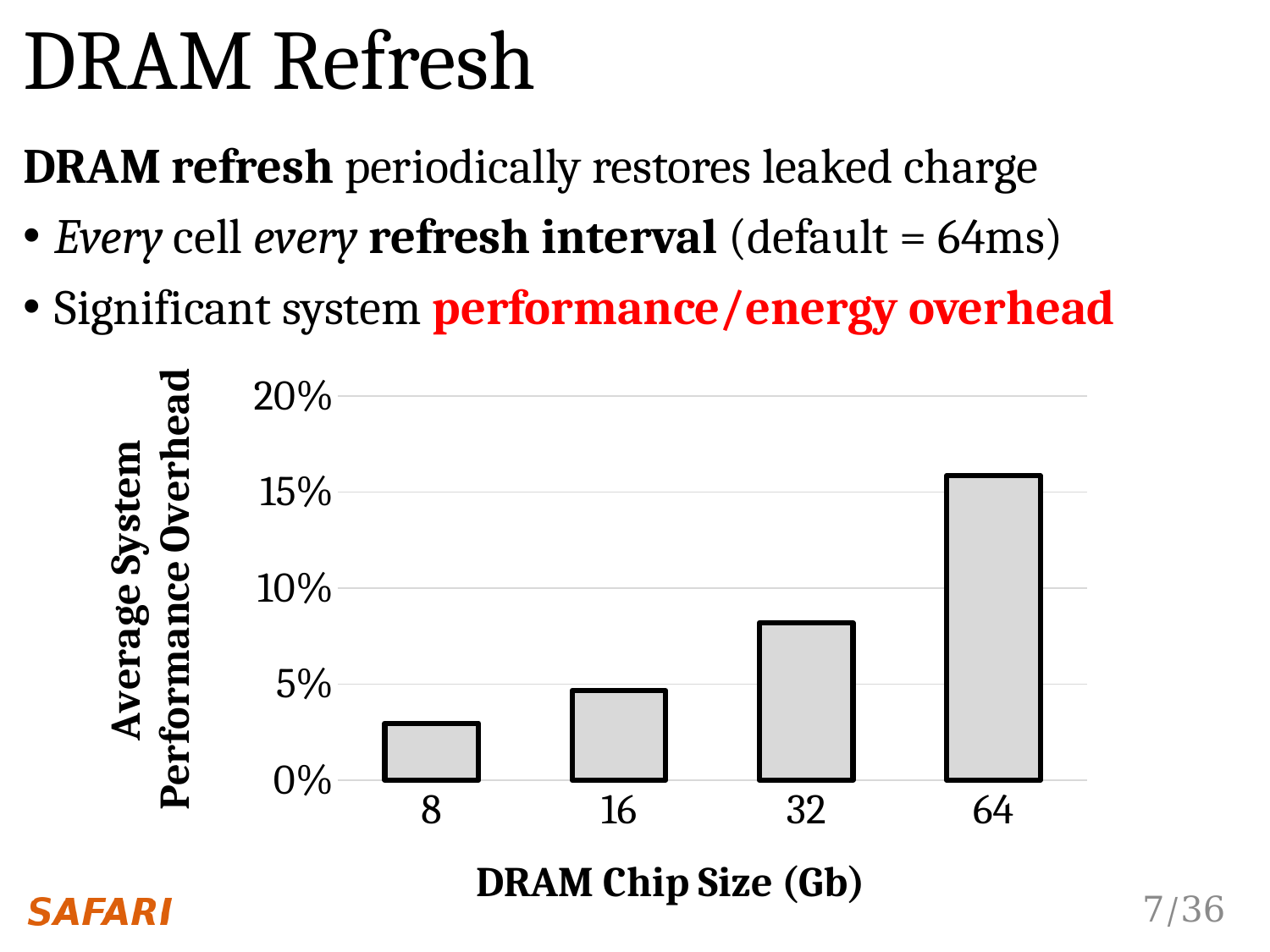
Is the average system performance overhead for the 8 Gb chip greater or less than 5%? less Which DRAM chip size has the lowest average system performance overhead? 8 Is the average system performance overhead for the 32 Gb chip greater or less than 10%? less What is the label of the y axis of the chart? Average System Performance Overhead Is the average system performance overhead for the 64 Gb chip greater or less than 15%? greater What is the label of the x axis of the chart? DRAM Chip Size (Gb) How many DRAM chip sizes are plotted in the chart? 4 Does the average system performance overhead rise or fall as DRAM chip size increases along the x axis? rises Which has a larger average system performance overhead, the 16 Gb chip or the 32 Gb chip? 32 Which DRAM chip size has the highest average system performance overhead? 64 What kind of chart is shown on the slide? bar chart